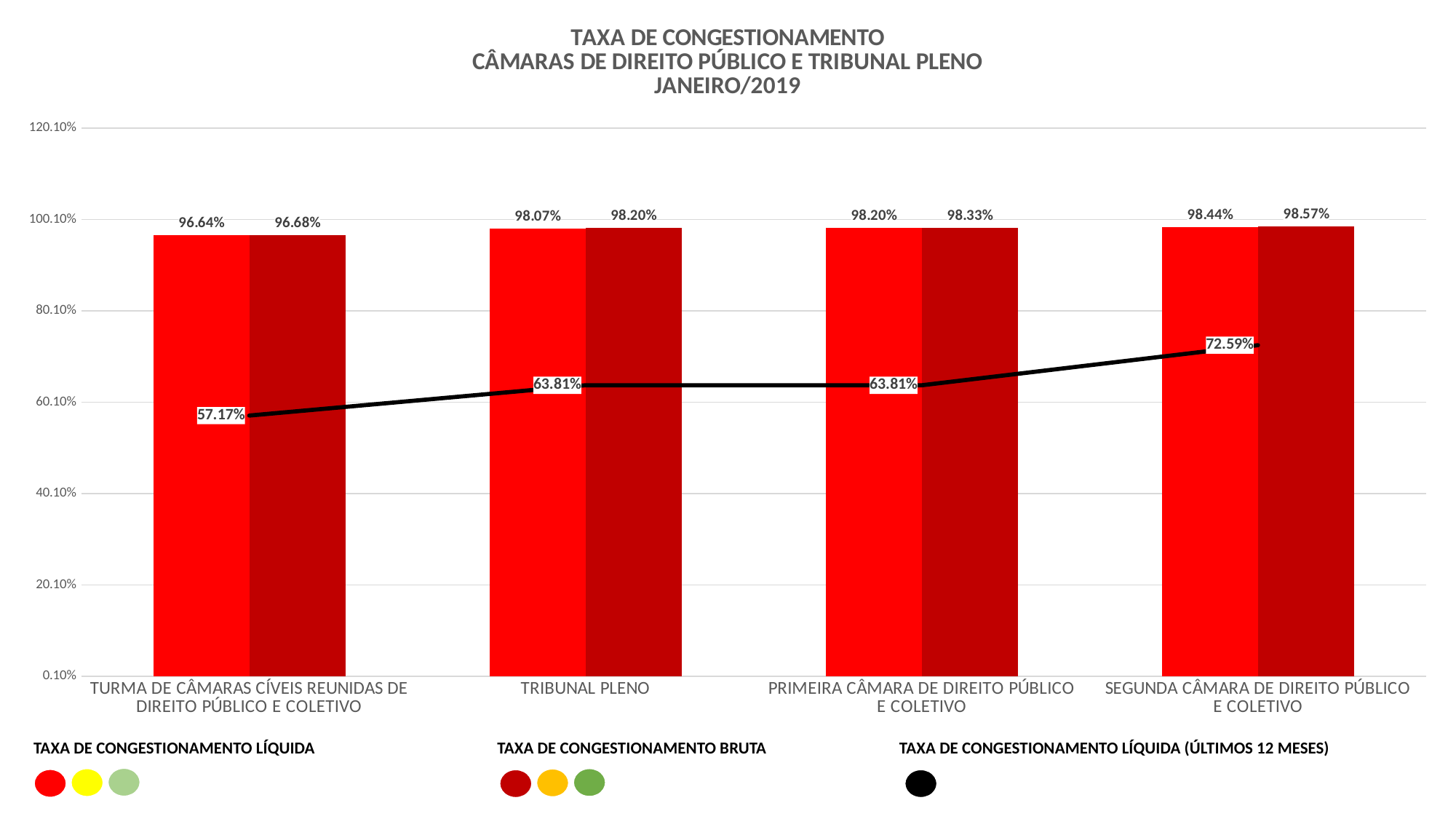
Which category has the lowest Taxa de Congestionamento Bruta? Turma de Câmaras Cíveis Reunidas de Direito Público e Coletivo How many categories are shown on the x axis? 4 What is the Taxa de Congestionamento Líquida (últimos 12 meses) for Turma de Câmaras Cíveis Reunidas de Direito Público e Coletivo? 57.17% What is the Taxa de Congestionamento Bruta for Segunda Câmara de Direito Público e Coletivo? 98.57% What is the difference between the Taxa de Congestionamento Bruta and the Taxa de Congestionamento Líquida for Tribunal Pleno? 0.13% Is the Taxa de Congestionamento Líquida (últimos 12 meses) for Segunda Câmara de Direito Público e Coletivo greater or less than 80.10%? less Does the Taxa de Congestionamento Líquida (últimos 12 meses) line rise or fall from the first category to the last? rise What is the Taxa de Congestionamento Líquida for Tribunal Pleno? 98.07% How many series does the legend list? 3 What is the Taxa de Congestionamento Bruta for Primeira Câmara de Direito Público e Coletivo? 98.33% Which category has the highest Taxa de Congestionamento Líquida (últimos 12 meses)? Segunda Câmara de Direito Público e Coletivo What is the difference between the Taxa de Congestionamento Líquida (últimos 12 meses) for Segunda Câmara de Direito Público e Coletivo and for Tribunal Pleno? 8.78%